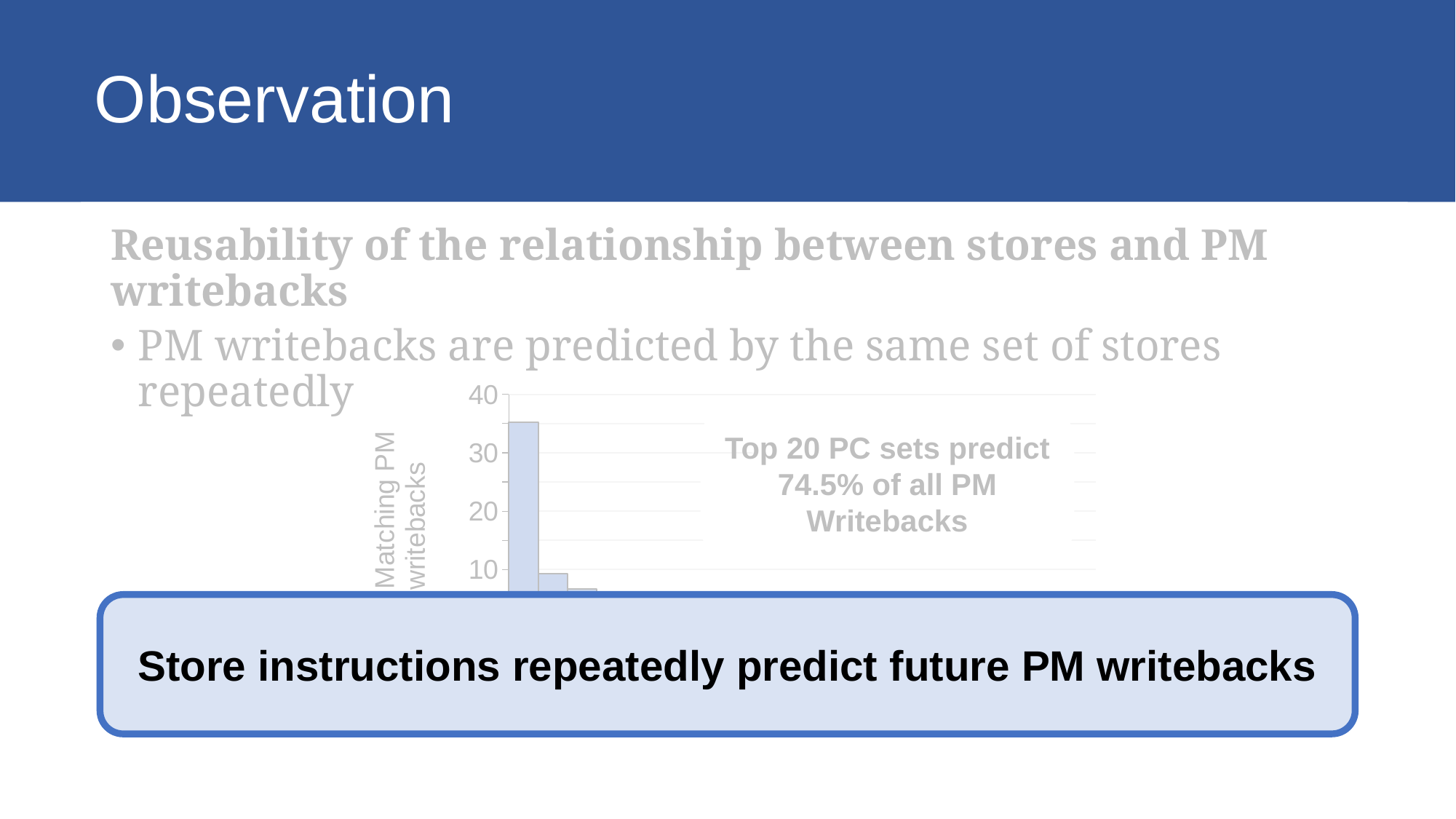
Do the bar values rise or fall moving from left to right along the x axis? fall Is the value of the leftmost (tallest) bar greater or less than 30? greater According to the annotation on the chart, what percentage of all PM writebacks do the top 20 PC sets predict? 74.5% What is the highest tick value shown on the vertical axis of the chart? 40 Which bar is the tallest in the chart? the leftmost bar What is the label on the vertical axis of the chart? Matching PM writebacks Is the value of the leftmost bar greater or less than 40? less Which is larger, the leftmost bar or the second bar from the left? the leftmost bar What kind of chart is shown on the slide? bar chart